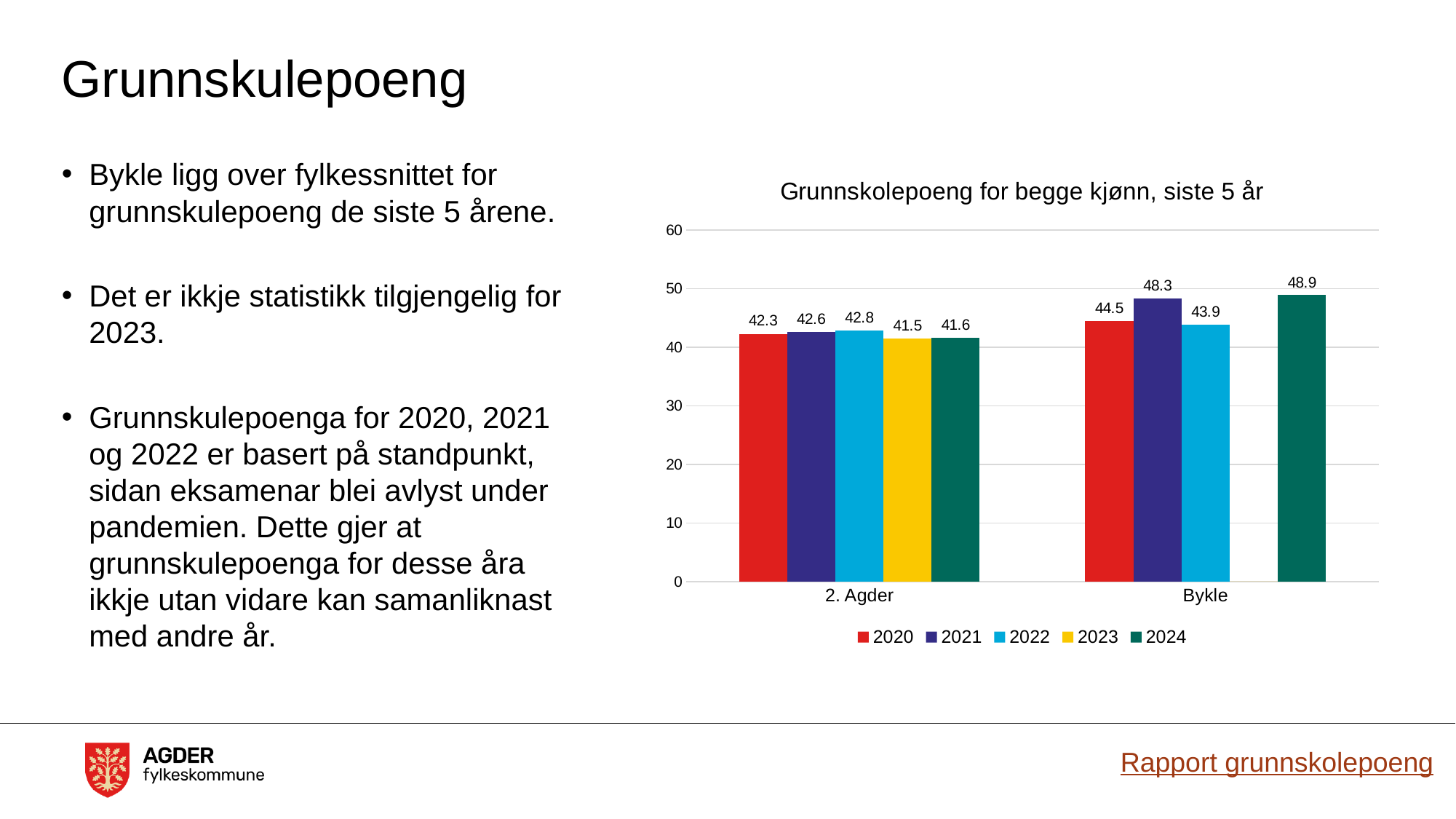
What is the value for 2. Agder in 2020? 42.3 What is the value for Bykle in 2024? 48.9 Which year has the highest value for Bykle? 2024 What is the value for Bykle in 2021? 48.3 What is the title of the chart? Grunnskolepoeng for begge kjønn, siste 5 år What is the value for 2. Agder in 2023? 41.5 Which is larger, the 2022 value for Bykle or the 2022 value for 2. Agder? Bykle How many series does the legend list? 5 What is the difference between Bykle and 2. Agder in 2024? 7.3 Which year has the lowest value for 2. Agder? 2023 What kind of chart is shown? Bar chart How many categories are shown on the x axis? 2